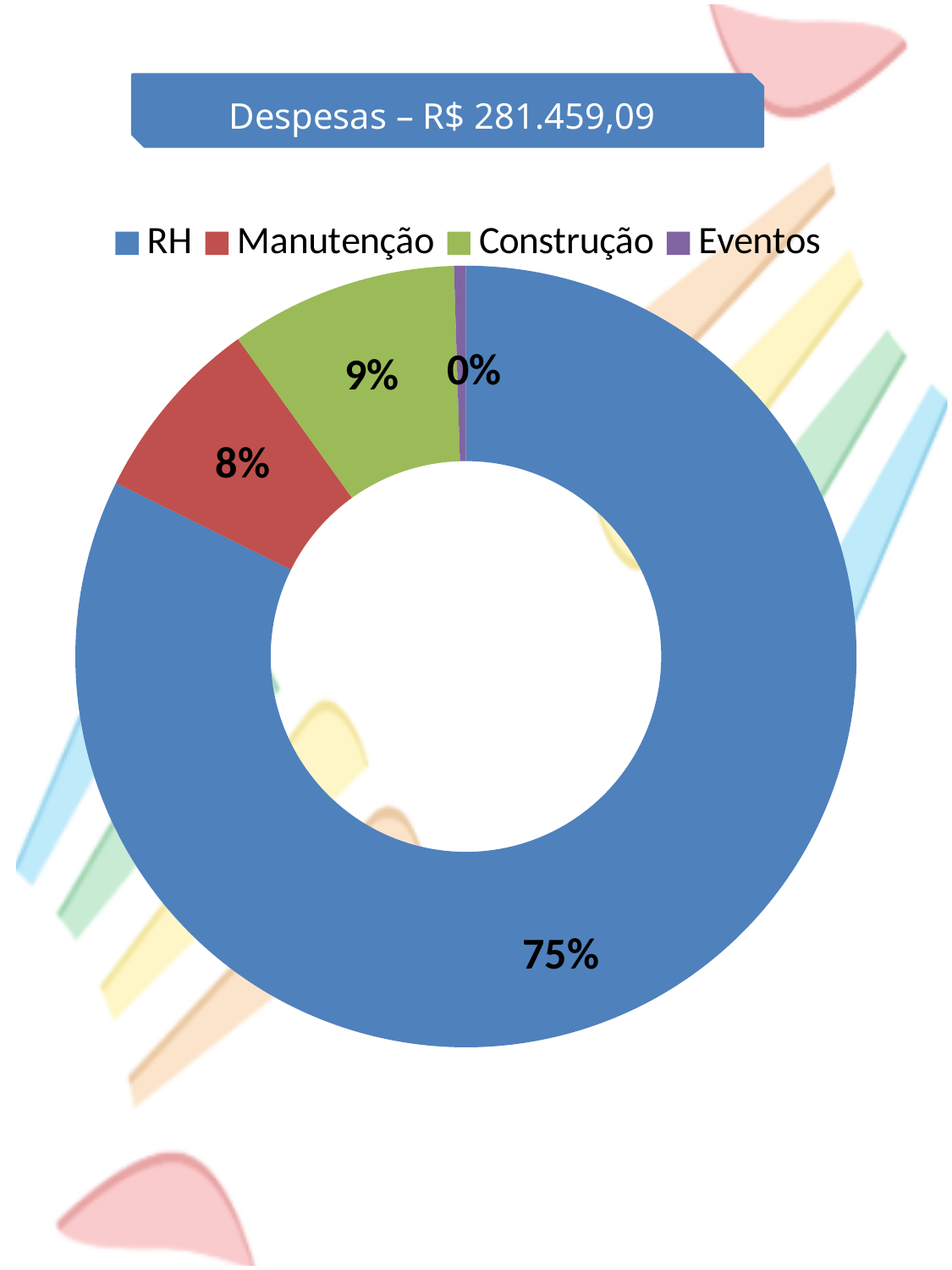
What share of the chart does Construção represent? 9% What share of the chart does Manutenção represent? 8% Which category has the largest share of the chart? RH What is the difference in percentage points between the RH share and the Construção share? 66 Which category has the smallest share of the chart? Eventos Which is larger, the share for Construção or the share for Manutenção? Construção How many categories does the legend list? 4 What share of the chart does RH represent? 75% What is the title of the chart? Despesas – R$ 281.459,09 What kind of chart is shown on the slide? Doughnut (pie) chart What colour is the RH slice? Blue